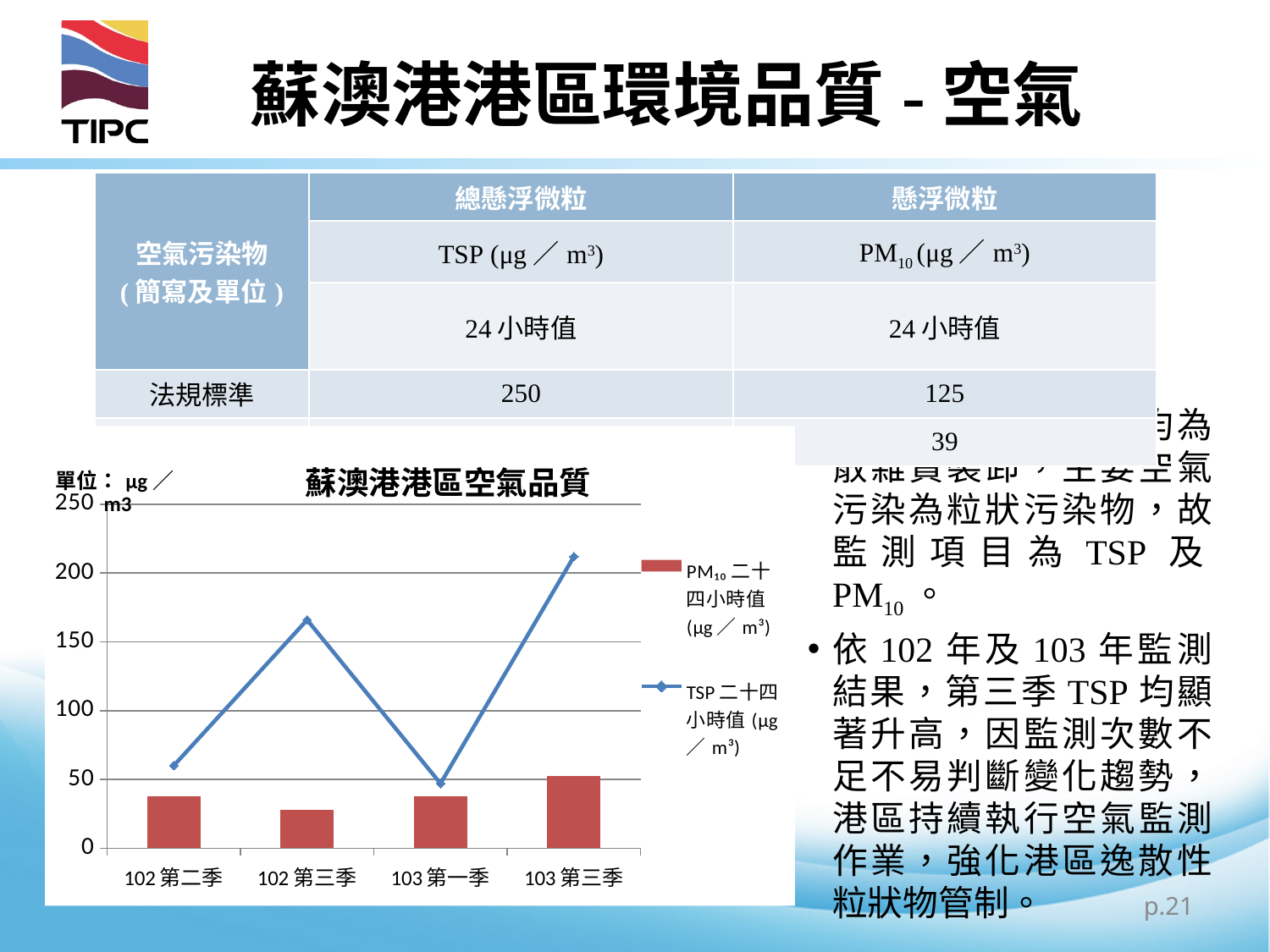
In which quarter is the TSP 二十四小時值 lowest? 103 第一季 Is the TSP 二十四小時值 for 103 第三季 greater or less than 200? greater In which quarter is the TSP 二十四小時值 highest? 103 第三季 What kind of chart is shown on the slide? A combined bar and line chart Which is larger, the TSP 二十四小時值 for 102 第三季 or for 103 第一季? 102 第三季 How many series does the chart legend list? 2 In which quarter is the PM₁₀ 二十四小時值 lowest? 102 第三季 What is the title of the chart? 蘇澳港港區空氣品質 Which series is drawn as a line in the chart? TSP 二十四小時值 (μg／m³) In which quarter is the PM₁₀ 二十四小時值 highest? 103 第三季 Is the PM₁₀ 二十四小時值 for 102 第三季 greater or less than 50? less How many categories are shown on the x axis of the chart? 4